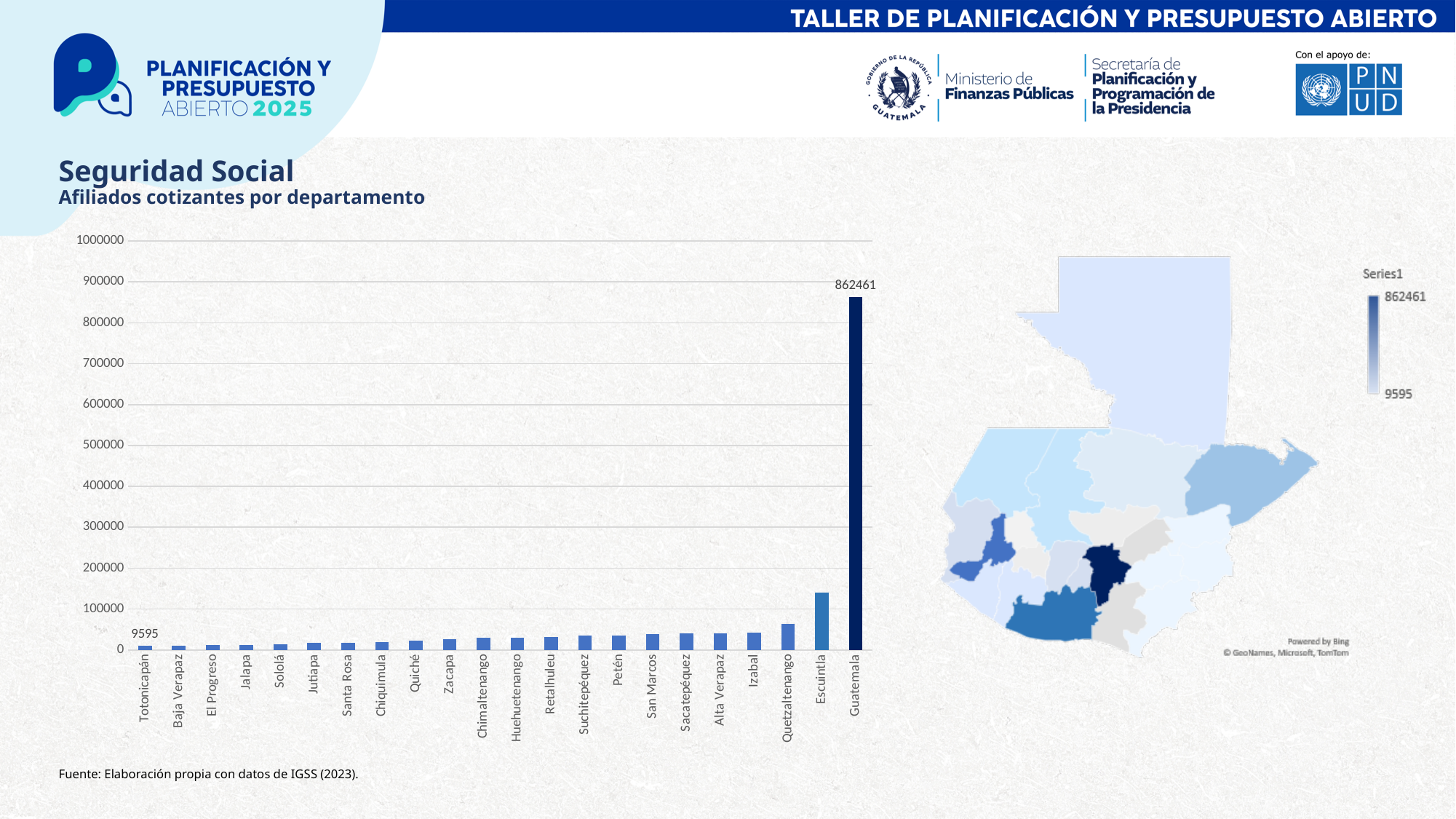
In the bar chart, what is the difference between the values for Guatemala and Totonicapán? 852866 In the bar chart, what is the value for Guatemala? 862461 How many departments are shown on the x axis of the bar chart? 22 What kind of chart is used on the left side of the slide to show afiliados cotizantes por departamento? Bar chart In the bar chart, what is the value for Totonicapán? 9595 In the bar chart, is the value for Escuintla greater or less than 100000? greater In the bar chart, which department has the lowest number of afiliados cotizantes? Totonicapán What is the subtitle of the chart under the heading 'Seguridad Social'? Afiliados cotizantes por departamento In the bar chart, do the values rise or fall from left to right along the x axis? Rise In the bar chart, which has a larger value, Escuintla or Quetzaltenango? Escuintla In the bar chart, is the value for Quetzaltenango greater or less than 100000? less In the bar chart, which department has the highest number of afiliados cotizantes? Guatemala